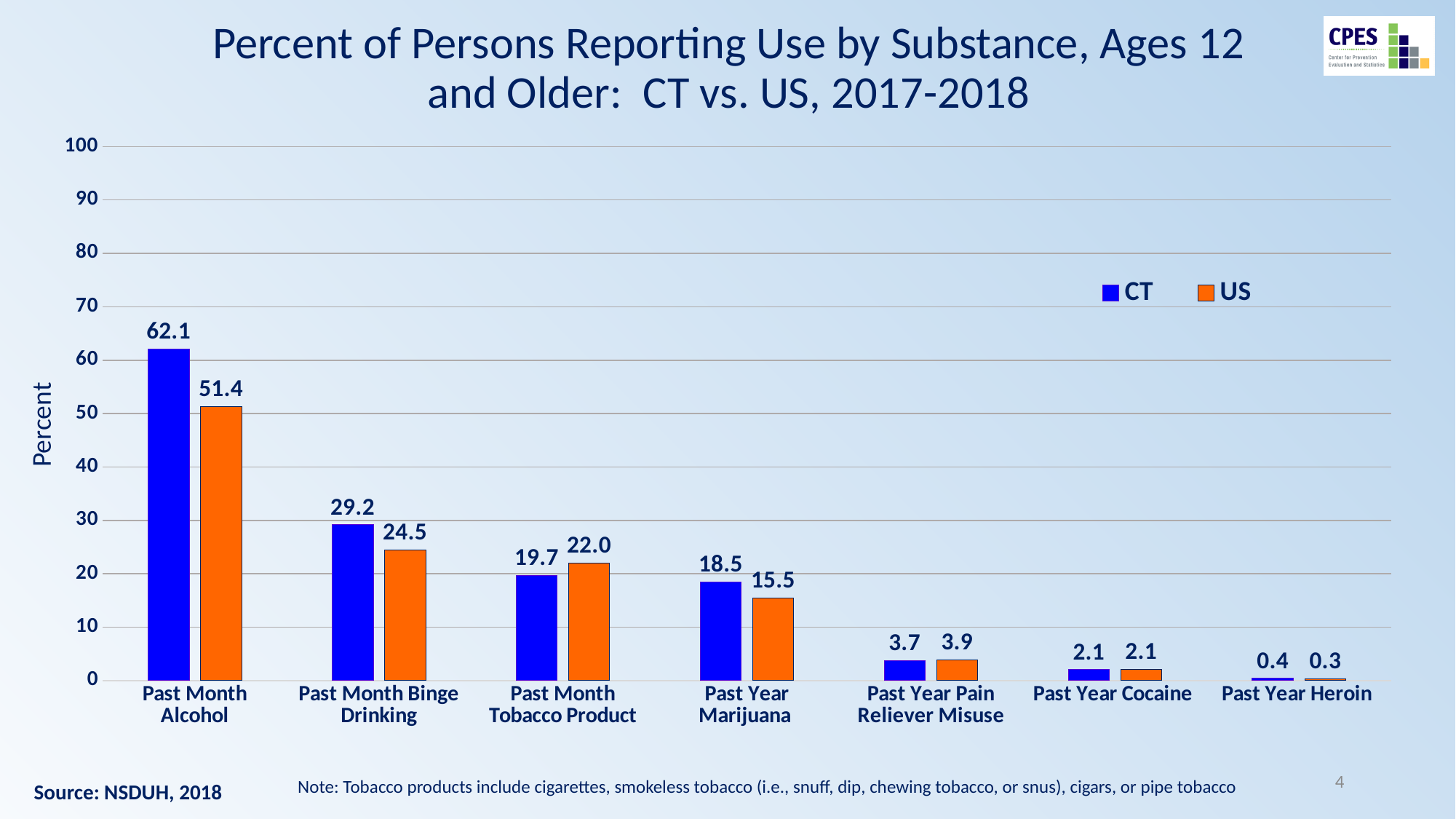
What is the CT value for Past Year Marijuana? 18.5 Which is larger for Past Month Tobacco Product, the CT value or the US value? US What is the difference between the CT and US values for Past Month Alcohol? 10.7 Which category has the highest US value? Past Month Alcohol What is the US value for Past Month Binge Drinking? 24.5 How many substance categories are shown on the x axis? 7 What is the CT value for Past Month Alcohol? 62.1 Is the CT value for Past Month Binge Drinking greater or less than 20? greater What is the label of the y axis? Percent How many series does the legend list? 2 What kind of chart is shown on the slide? Bar chart Which category has the lowest CT value? Past Year Heroin